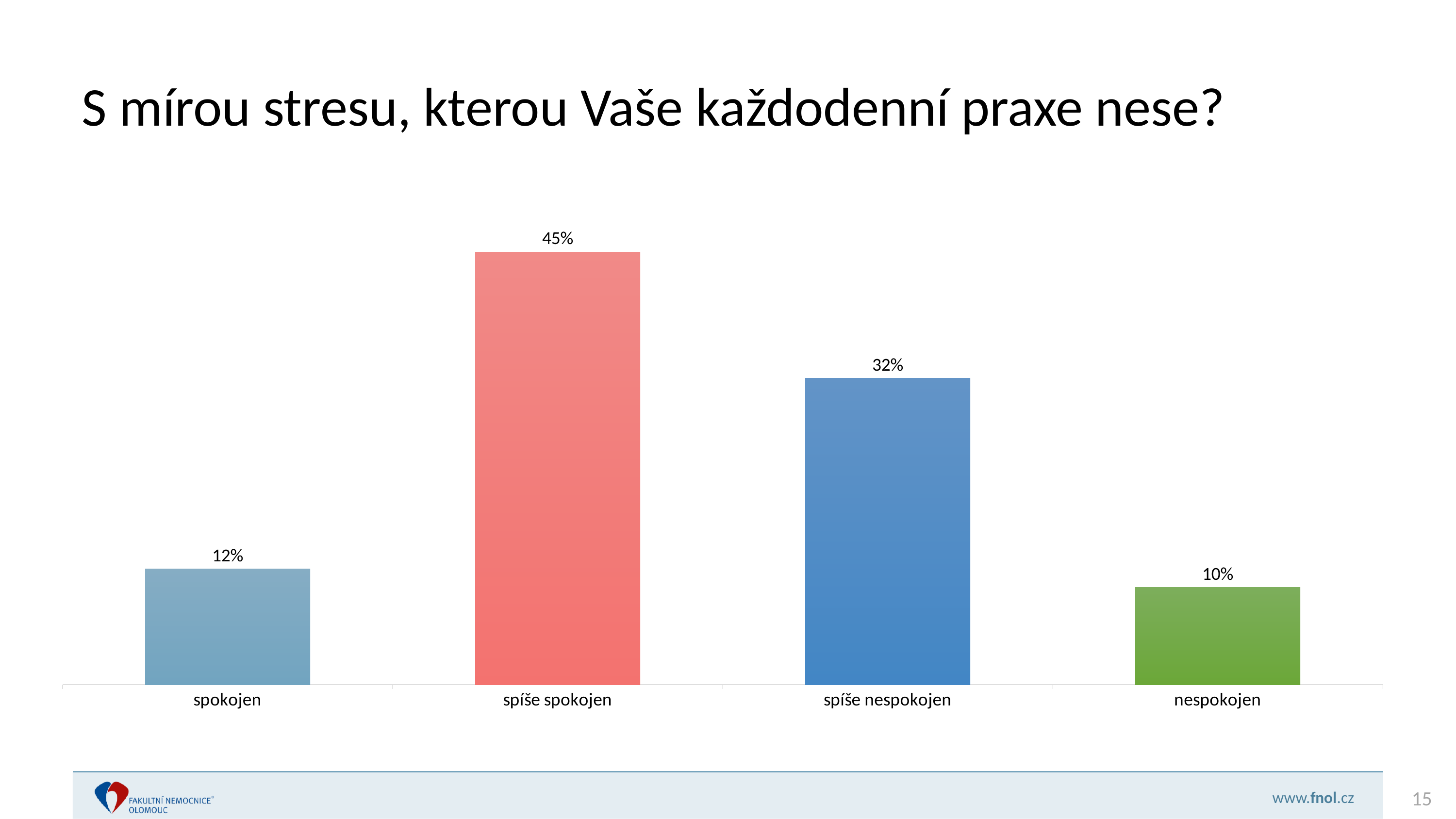
What kind of chart is shown on the slide? bar chart What is the value for "nespokojen"? 10% Which category has the highest value? spíše spokojen What is the title of the slide? S mírou stresu, kterou Vaše každodenní praxe nese? Which is larger, the value for "spíše nespokojen" or the value for "spokojen"? spíše nespokojen Which category has the lowest value? nespokojen What is the value for "spíše spokojen"? 45% What is the value for "spokojen"? 12% What is the difference between the values for "spokojen" and "nespokojen"? 2% What is the value for "spíše nespokojen"? 32% What is the difference between the values for "spíše spokojen" and "spíše nespokojen"? 13% How many categories are shown in the chart? 4